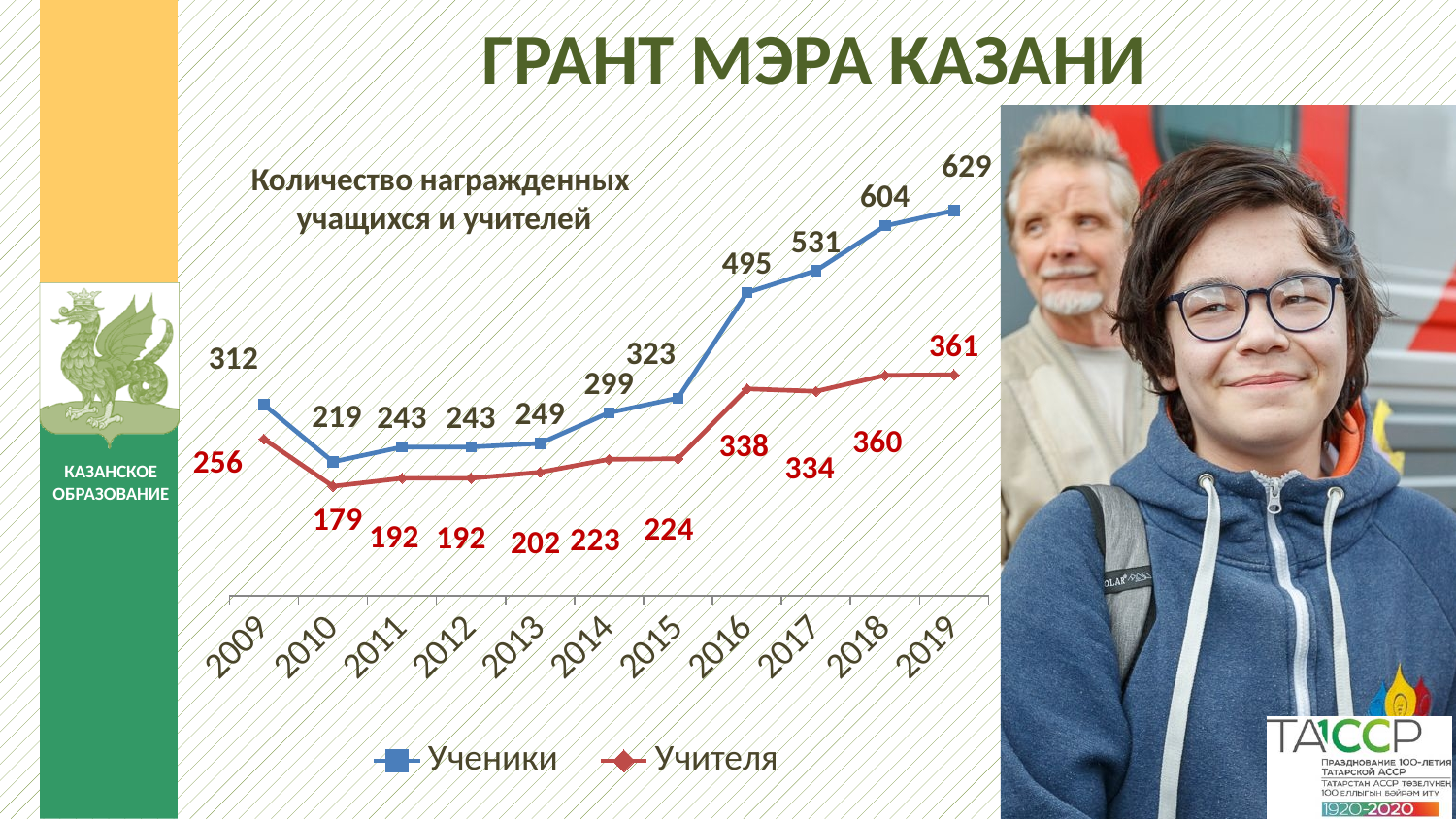
What is the value for Учителя in 2013? 202 What type of chart is shown on the slide? line chart In which year is the value for Ученики the lowest? 2010 What is the value for Ученики in 2019? 629 What is the title of the chart? Количество награжденных учащихся и учителей What is the value for Ученики in 2016? 495 What is the value for Учителя in 2009? 256 How many series does the legend list? 2 How many years are shown on the x axis? 11 In which year is the value for Учителя the highest? 2019 What is the difference between the Ученики and Учителя values in 2019? 268 Which is larger: the Ученики value in 2009 or the Ученики value in 2015? 2015